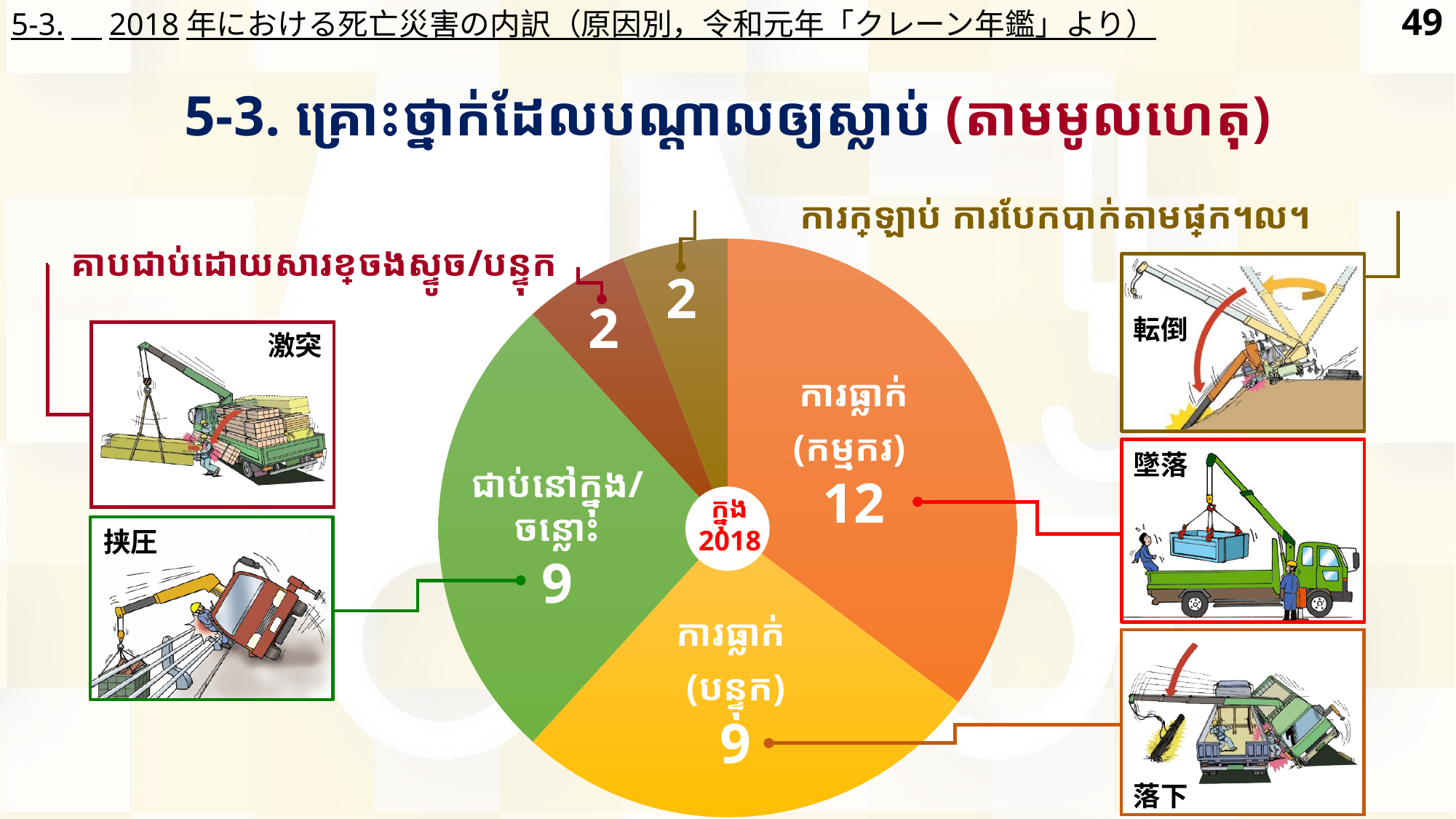
What kind of chart is shown on the slide? Pie chart What is the value of the ជាប់នៅក្នុង/ចន្លោះ slice in the pie chart? 9 Which is larger, the ការធ្លាក់ (កម្មករ) slice or the ជាប់នៅក្នុង/ចន្លោះ slice? ការធ្លាក់ (កម្មករ) How many slices does the pie chart have? 5 What is the value of the ការធ្លាក់ (កម្មករ) slice in the pie chart? 12 What is the value of the ការធ្លាក់ (បន្ទុក) slice in the pie chart? 9 Which category has the largest slice in the pie chart? ការធ្លាក់ (កម្មករ) What is the difference between the ការធ្លាក់ (កម្មករ) value and the ការធ្លាក់ (បន្ទុក) value? 3 What is the value of the គាបជាប់ដោយសារខុចងស្ទូច/បន្ទុក slice in the pie chart? 2 What is the value of the ការក្រឡាប់ ការបែកបាក់តាមផ្នែកៗលៗ slice in the pie chart? 2 What is the total of all the values shown in the pie chart? 34 What year is written in the centre of the pie chart? 2018